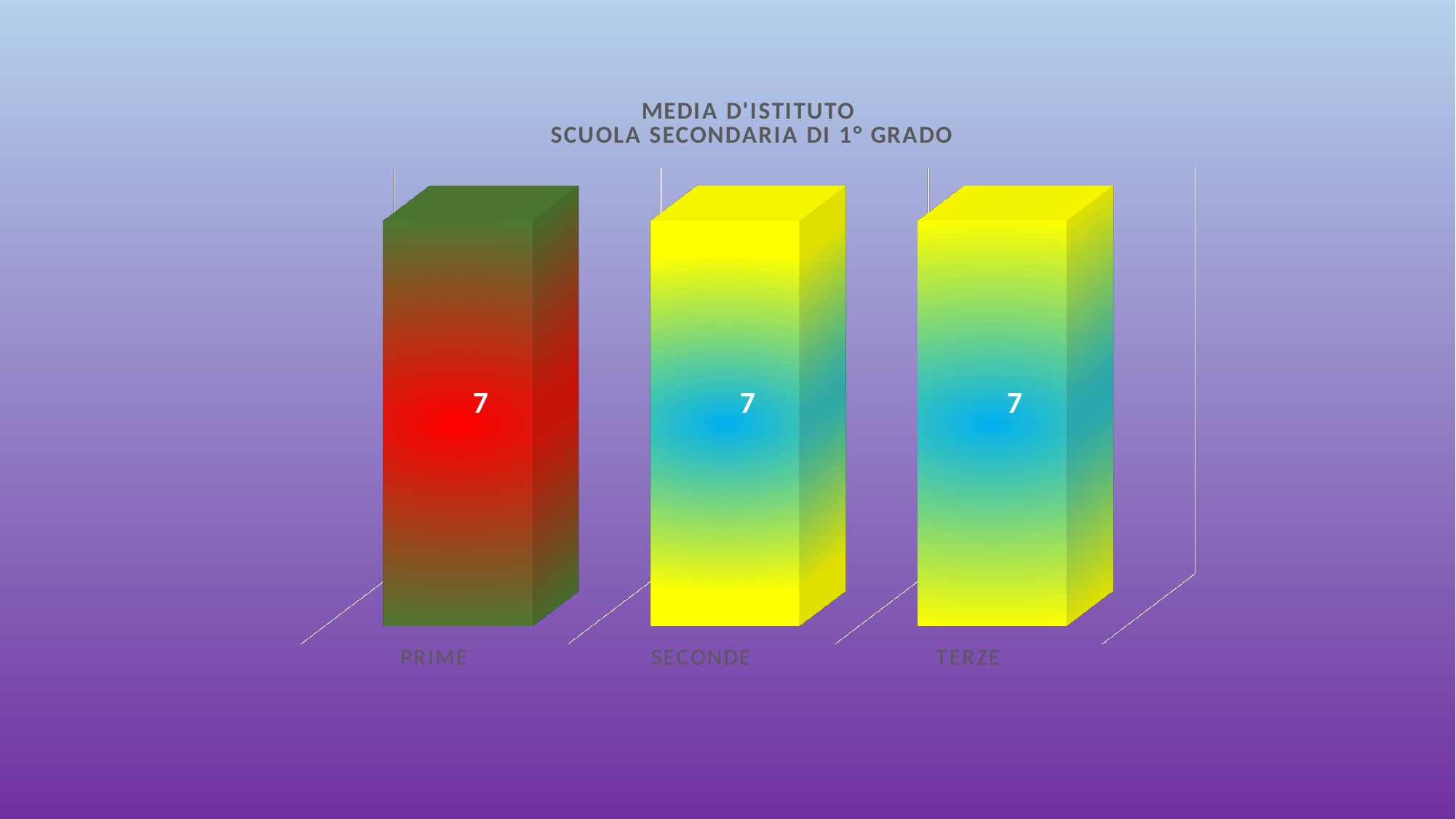
Which category's bar is coloured red? PRIME What is the value for TERZE? 7 What kind of chart is shown on the slide? bar chart What is the total of the values for PRIME, SECONDE and TERZE? 21 What is the title of the chart? MEDIA D'ISTITUTO SCUOLA SECONDARIA DI 1° GRADO How many categories are shown on the x axis? 3 What is the value for PRIME? 7 Do the values rise, fall or stay the same from PRIME to TERZE? stay the same What is the difference between the values for PRIME and TERZE? 0 What is the value for SECONDE? 7